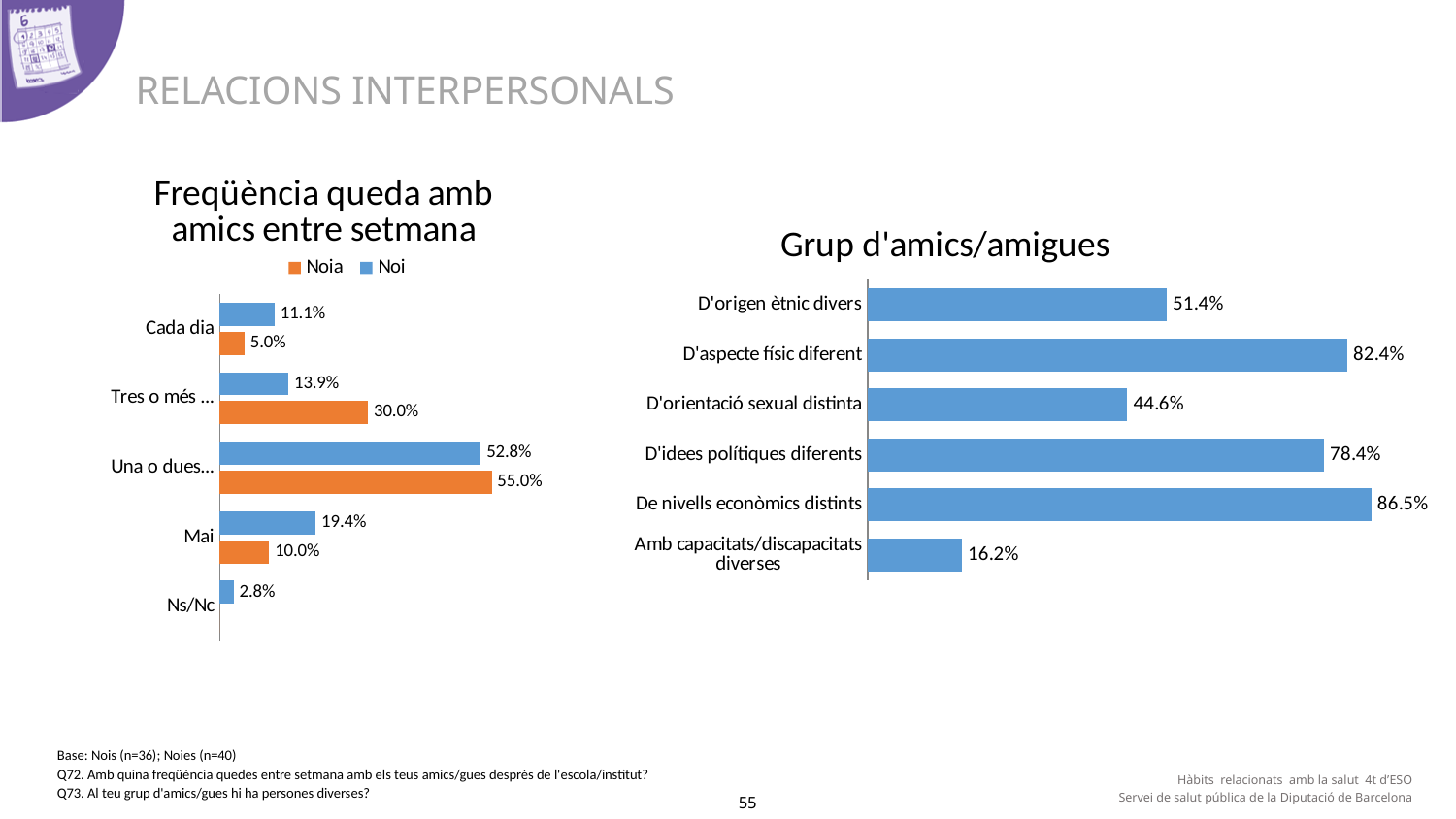
In the 'Grup d'amics/amigues' chart, what is the value for 'De nivells econòmics distints'? 86.5% In the 'Freqüència queda amb amics entre setmana' chart, how many series does the legend list? 2 In the 'Grup d'amics/amigues' chart, which category has the highest value? De nivells econòmics distints In the 'Grup d'amics/amigues' chart, what is the difference between 'D'aspecte físic diferent' and 'D'orientació sexual distinta'? 37.8% In the 'Freqüència queda amb amics entre setmana' chart, what is the Noia value for 'Tres o més ...'? 30.0% In the 'Freqüència queda amb amics entre setmana' chart, which is larger for 'Cada dia': Noi or Noia? Noi In the 'Grup d'amics/amigues' chart, which category has the lowest value? Amb capacitats/discapacitats diverses In the 'Grup d'amics/amigues' chart, how many categories are shown? 6 In the 'Freqüència queda amb amics entre setmana' chart, what is the difference between the Noia and Noi values for 'Mai'? 9.4% In the 'Freqüència queda amb amics entre setmana' chart, which colour represents Noia? Orange What kind of chart is the 'Grup d'amics/amigues' chart? Bar chart In the 'Freqüència queda amb amics entre setmana' chart, what is the Noi value for 'Mai'? 19.4%